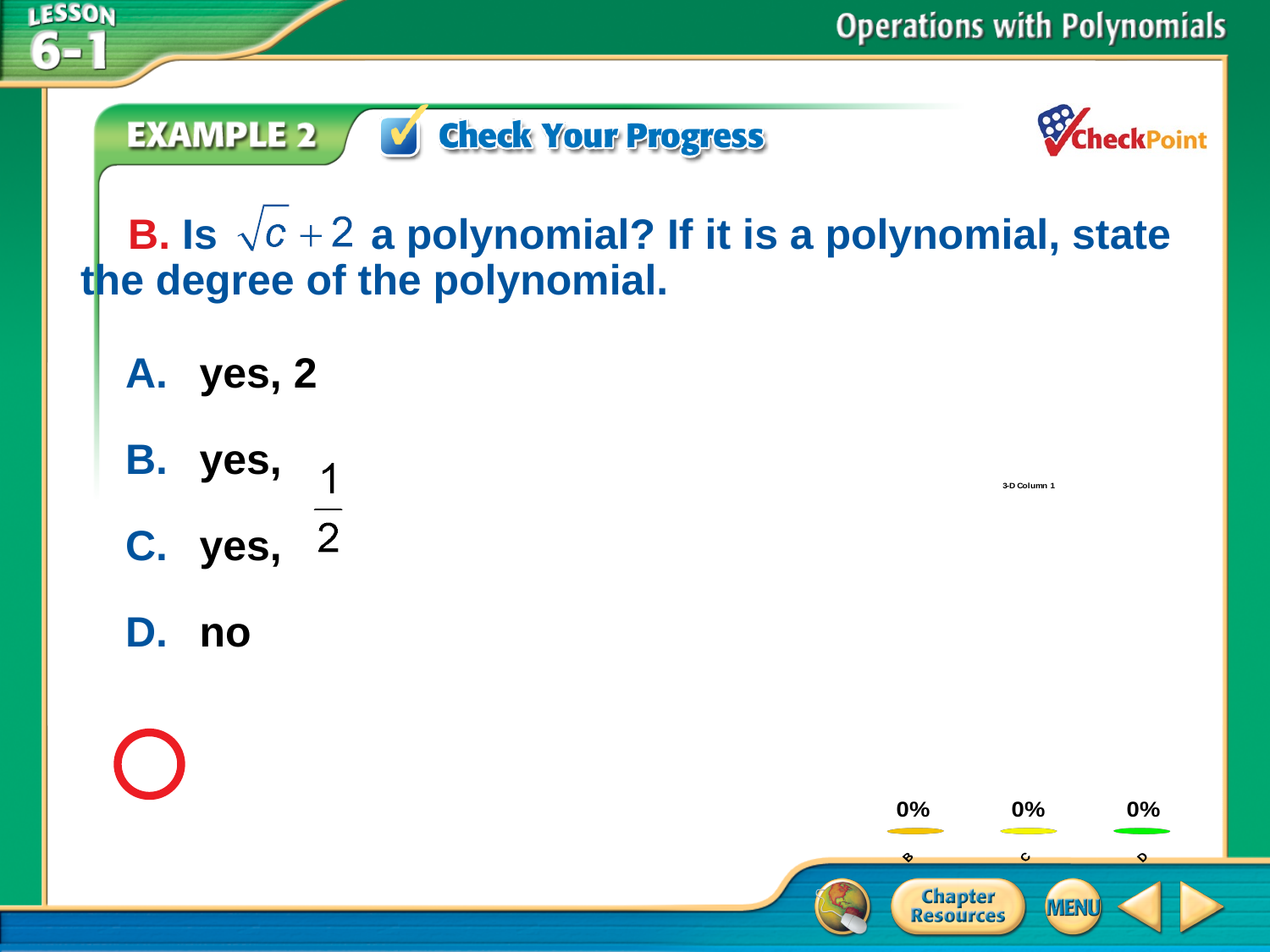
What is the value shown for category D in the chart? 0% What is the value shown for category B in the chart? 0% What kind of chart is shown on the slide? bar chart What is the value shown for category C in the chart? 0%